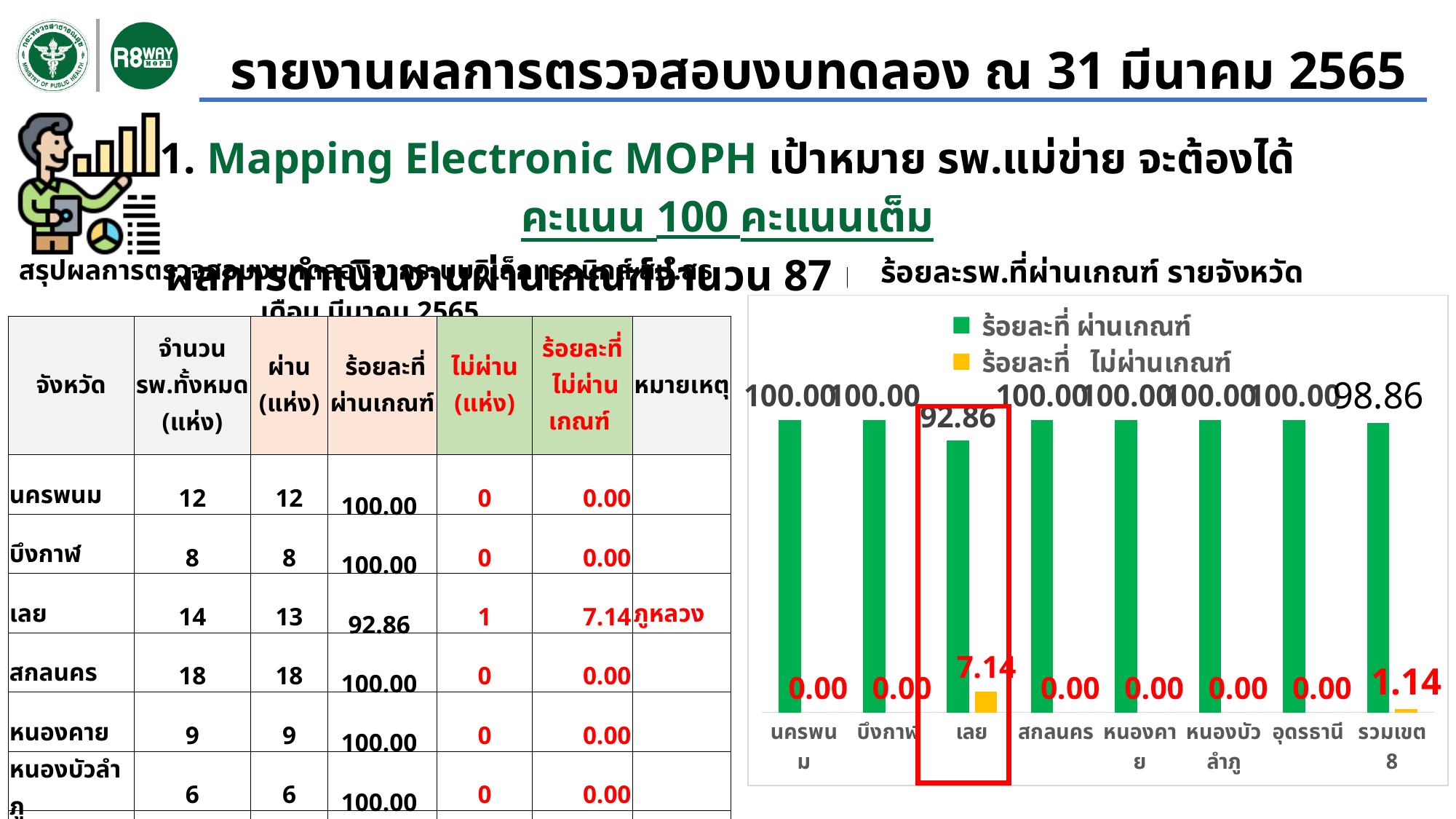
In the bar chart, which category has the lowest value for ร้อยละที่ ผ่านเกณฑ์? เลย In the bar chart, which is larger: the ร้อยละที่ ผ่านเกณฑ์ value for เลย or for รวมเขต 8? รวมเขต 8 What colour represents the ร้อยละที่ ไม่ผ่านเกณฑ์ series in the bar chart? yellow How many series does the legend of the bar chart list? 2 In the bar chart, what is the value of ร้อยละที่ ผ่านเกณฑ์ for เลย? 92.86 What type of chart is shown on the right side of the slide? bar chart In the bar chart, what is the value of ร้อยละที่ ไม่ผ่านเกณฑ์ for เลย? 7.14 In the bar chart, what is the difference between the ร้อยละที่ ผ่านเกณฑ์ values for นครพนม and เลย? 7.14 How many categories are shown on the x axis of the bar chart? 8 In the bar chart, what is the value of ร้อยละที่ ไม่ผ่านเกณฑ์ for รวมเขต 8? 1.14 In the bar chart, what is the value of ร้อยละที่ ผ่านเกณฑ์ for รวมเขต 8? 98.86 In the bar chart, which category has the highest value for ร้อยละที่ ไม่ผ่านเกณฑ์? เลย